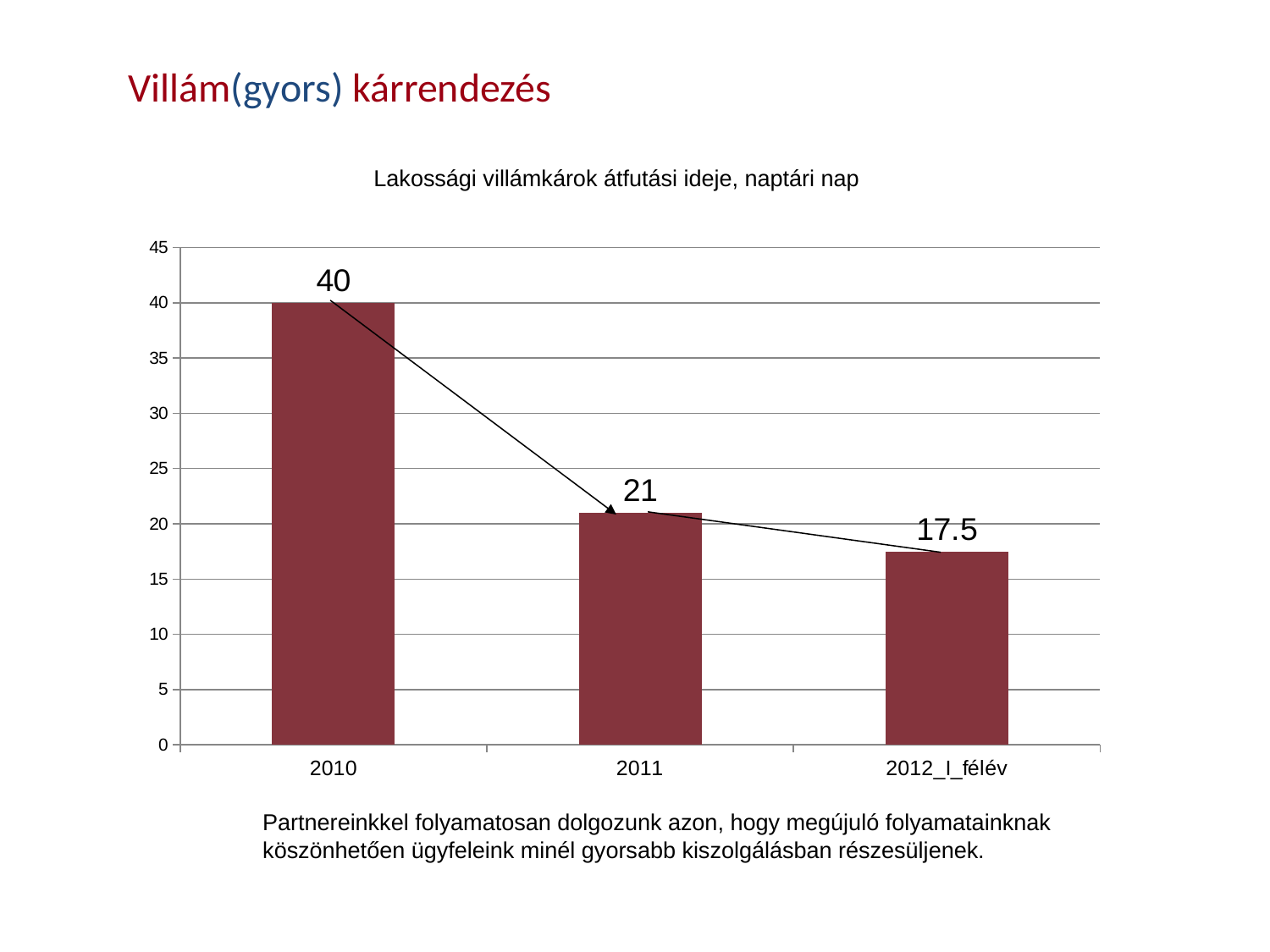
What kind of chart is shown on the slide? bar chart What is the value for 2011? 21 What is the value for 2012_I_félév? 17.5 Which is larger, the value for 2011 or the value for 2012_I_félév? 2011 Which category has the lowest value? 2012_I_félév Do the values rise or fall from 2010 to 2012_I_félév? fall What is the difference between the values for 2011 and 2012_I_félév? 3.5 What is the value for 2010? 40 Which category has the highest value? 2010 How many categories are shown on the x axis? 3 Is the value for 2011 greater or less than 25? less What is the difference between the values for 2010 and 2011? 19